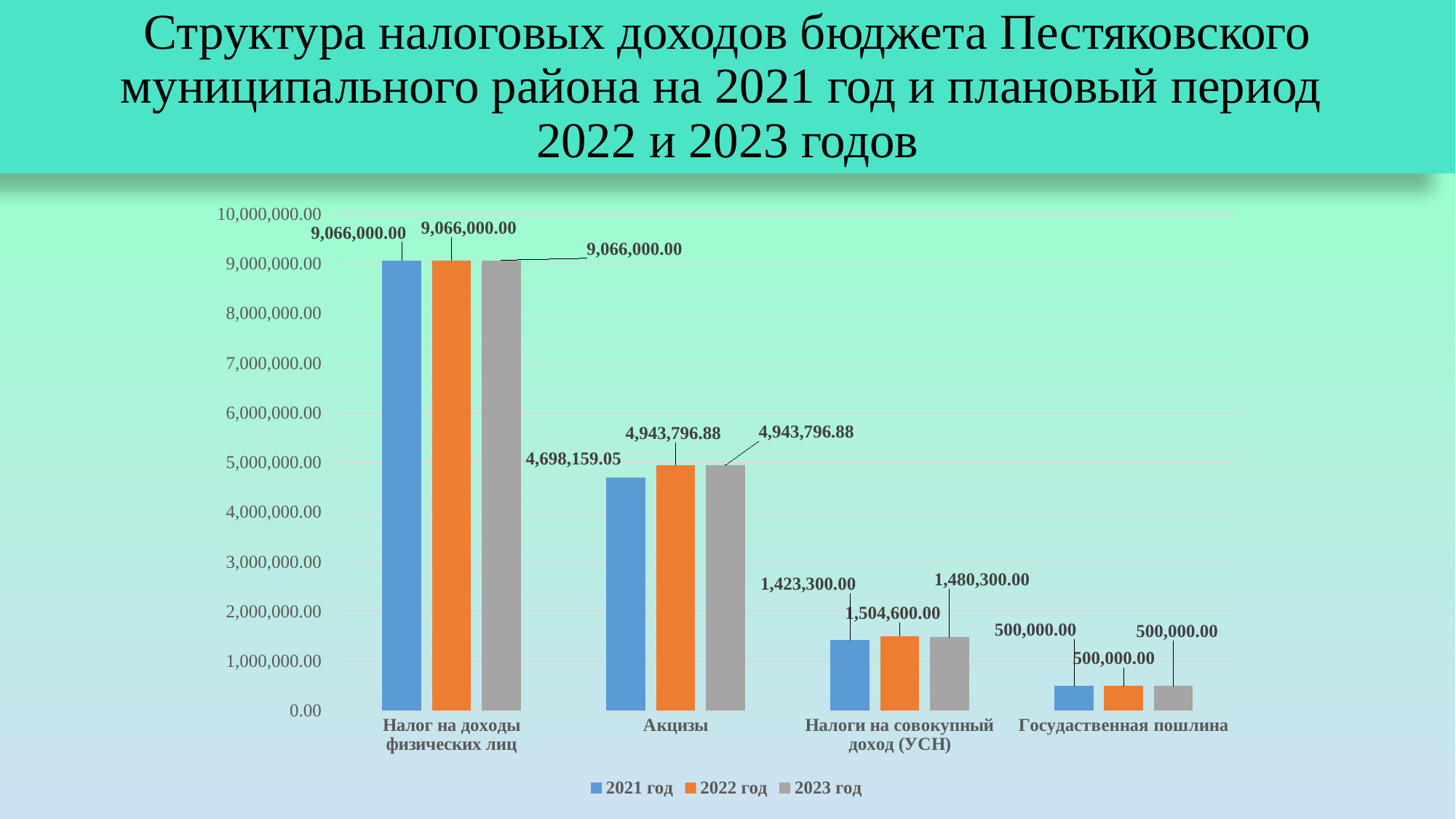
Which category has the lowest value in the 2023 год series? Государственная пошлина What is the value for Налог на доходы физических лиц in the 2023 год series? 9,066,000.00 How many series does the legend list? 3 Which category has the highest value in the 2022 год series? Налог на доходы физических лиц How many categories are shown on the x axis? 4 What is the value for Акцизы in the 2021 год series? 4,698,159.05 Which is larger for Налоги на совокупный доход (УСН): the 2022 год value or the 2023 год value? 2022 год What is the value for Государственная пошлина in the 2021 год series? 500,000.00 What is the value for Налоги на совокупный доход (УСН) in the 2022 год series? 1,504,600.00 What is the difference between the 2022 год and 2021 год values for Акцизы? 245,637.83 What kind of chart is shown on the slide? bar chart Which series is shown in orange in the legend? 2022 год